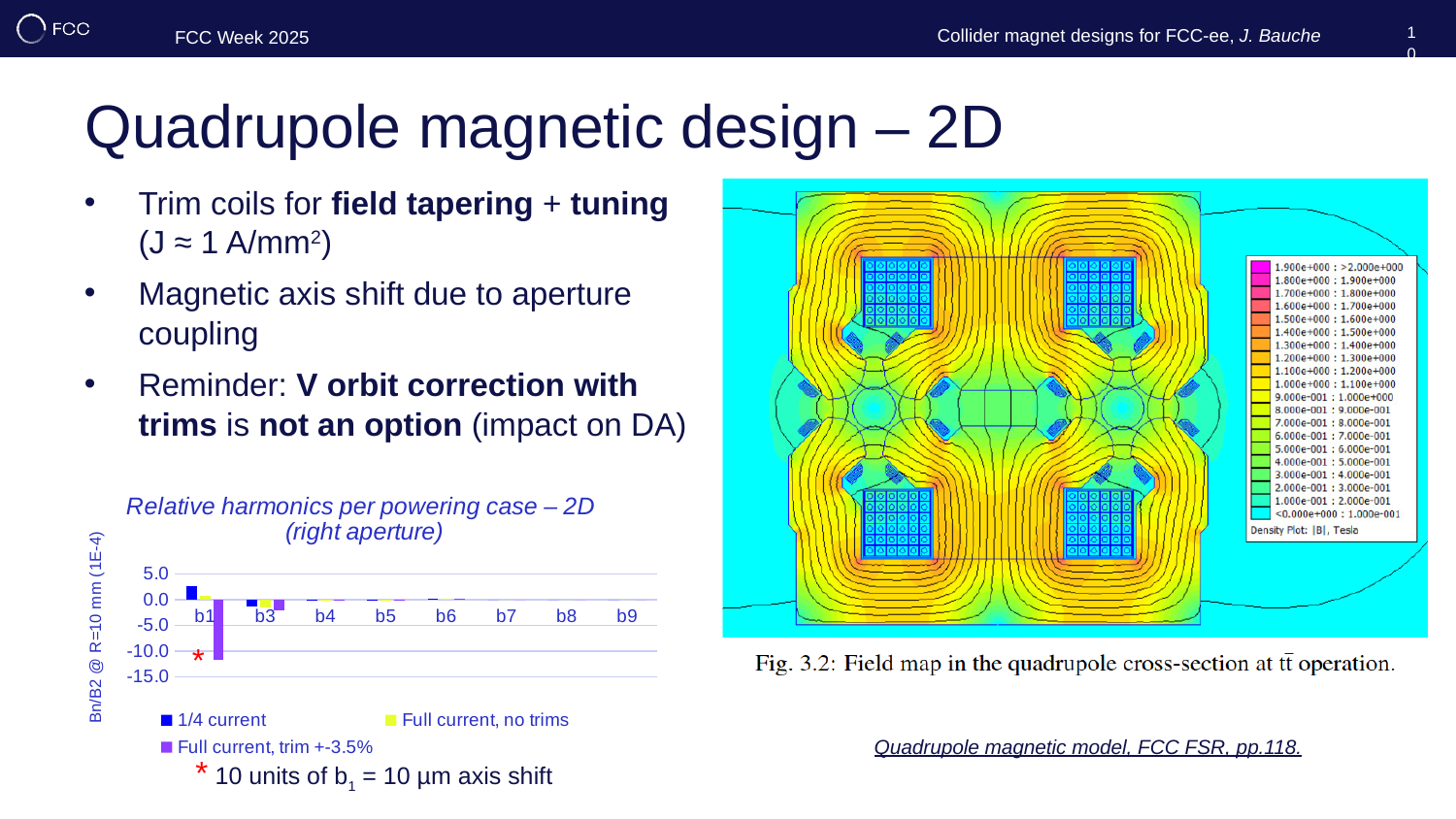
In the 'Relative harmonics per powering case' chart, at b1, which is larger: the '1/4 current' value or the 'Full current, trim +-3.5%' value? 1/4 current What is the y-axis label of the 'Relative harmonics per powering case' chart? Bn/B2 @ R=10 mm (1E-4) In the 'Relative harmonics per powering case' chart, is the value for '1/4 current' at b1 greater or less than 0.0? greater How many series does the legend of the 'Relative harmonics per powering case' chart list? 3 In the 'Relative harmonics per powering case' chart, is the value for '1/4 current' at b1 greater or less than 5.0? less How many harmonic categories are shown on the x axis of the 'Relative harmonics per powering case' chart? 8 In the 'Relative harmonics per powering case' chart, is the value for 'Full current, trim +-3.5%' at b1 greater or less than -5.0? less In the 'Relative harmonics per powering case' chart, which category has the lowest (most negative) bar? b1 In the 'Relative harmonics per powering case' chart, which series has the highest (most positive) bar in the chart? 1/4 current What kind of chart is 'Relative harmonics per powering case – 2D (right aperture)'? bar chart What is the title of the bar chart on the slide? Relative harmonics per powering case – 2D (right aperture) In the 'Relative harmonics per powering case' chart, which series has the lowest value at b1? Full current, trim +-3.5%